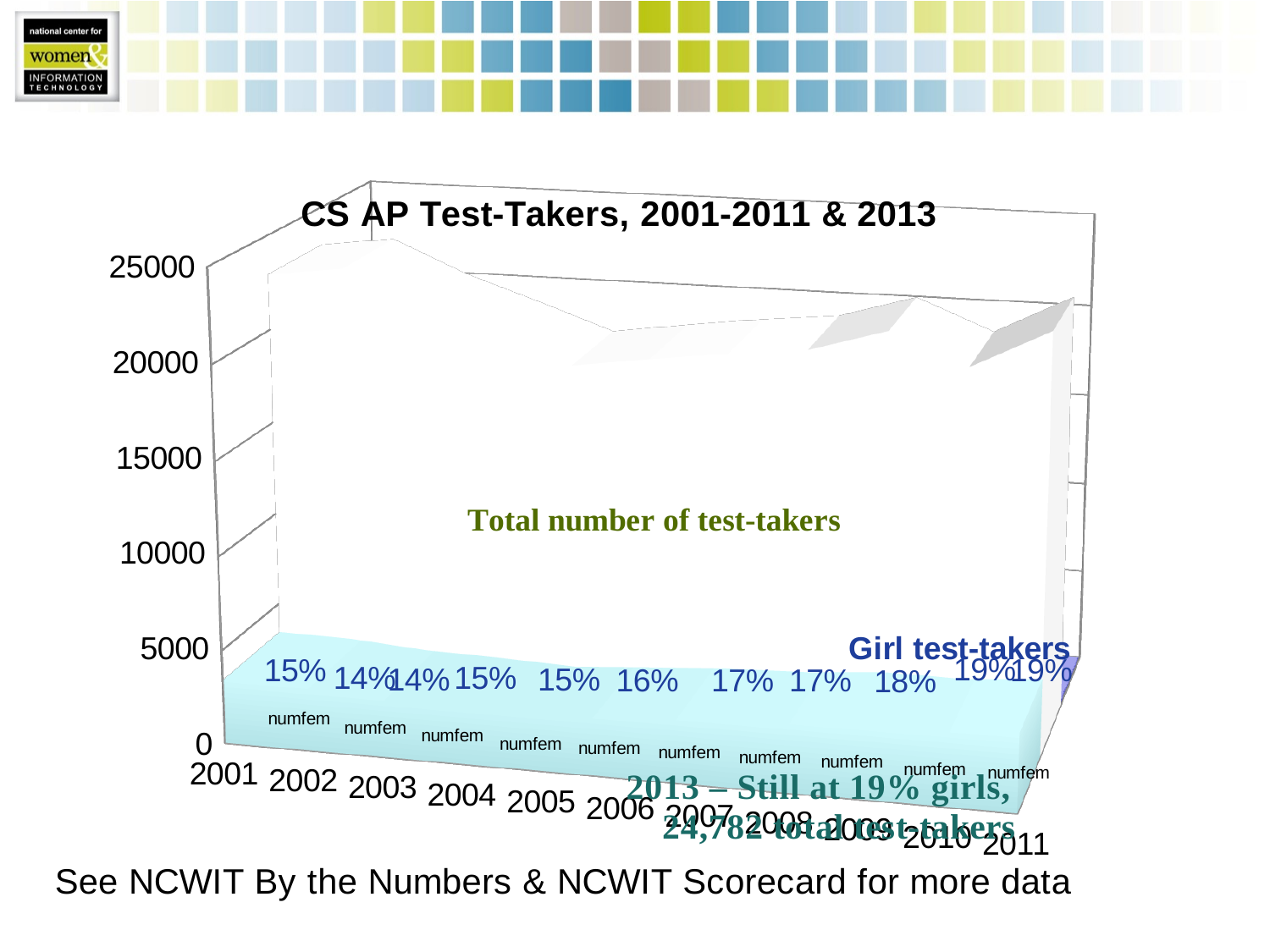
What is the lowest girl percentage shown on the chart? 14% Which year has the larger girl percentage, 2002 or 2009? 2009 Is the number of girl test-takers in 2001 greater or less than 5000? less By how many percentage points did the girl share change from 2001 to 2011? 4 percentage points What is the highest girl percentage shown on the chart? 19% Does the girl percentage generally rise or fall from 2001 to 2011? rise What kind of chart is shown on the slide? area chart What percentage of CS AP test-takers were girls in 2011? 19% What percentage of CS AP test-takers were girls in 2001? 15% What percentage of CS AP test-takers were girls in 2006? 16% What is the title of the chart? CS AP Test-Takers, 2001-2011 & 2013 How many years are labelled along the x axis of the chart? 11